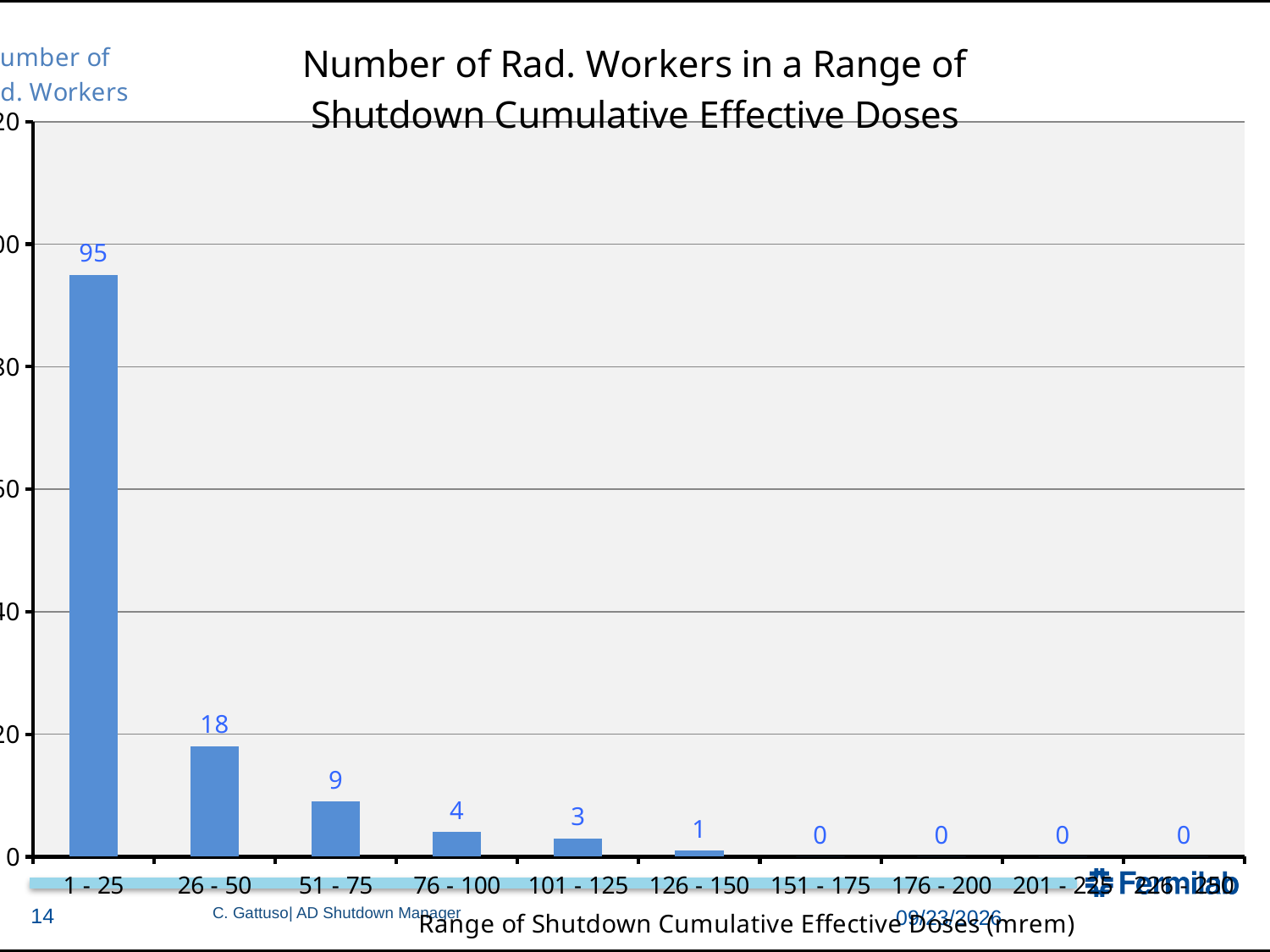
What type of chart is shown on the slide? bar chart How many rad. workers are in the 26 - 50 mrem dose range? 18 Do the values rise or fall as the dose range increases along the x axis? fall What is the title of the chart? Number of Rad. Workers in a Range of Shutdown Cumulative Effective Doses What is the label of the x axis? Range of Shutdown Cumulative Effective Doses (mrem) Which dose range has the highest number of rad. workers? 1 - 25 How many rad. workers are in the 126 - 150 mrem dose range? 1 Which has more rad. workers, the 76 - 100 range or the 101 - 125 range? 76 - 100 What is the difference between the number of rad. workers in the 1 - 25 range and the 26 - 50 range? 77 How many rad. workers are in the 51 - 75 mrem dose range? 9 How many rad. workers are in the 1 - 25 mrem dose range? 95 How many dose range categories are plotted on the x axis? 10